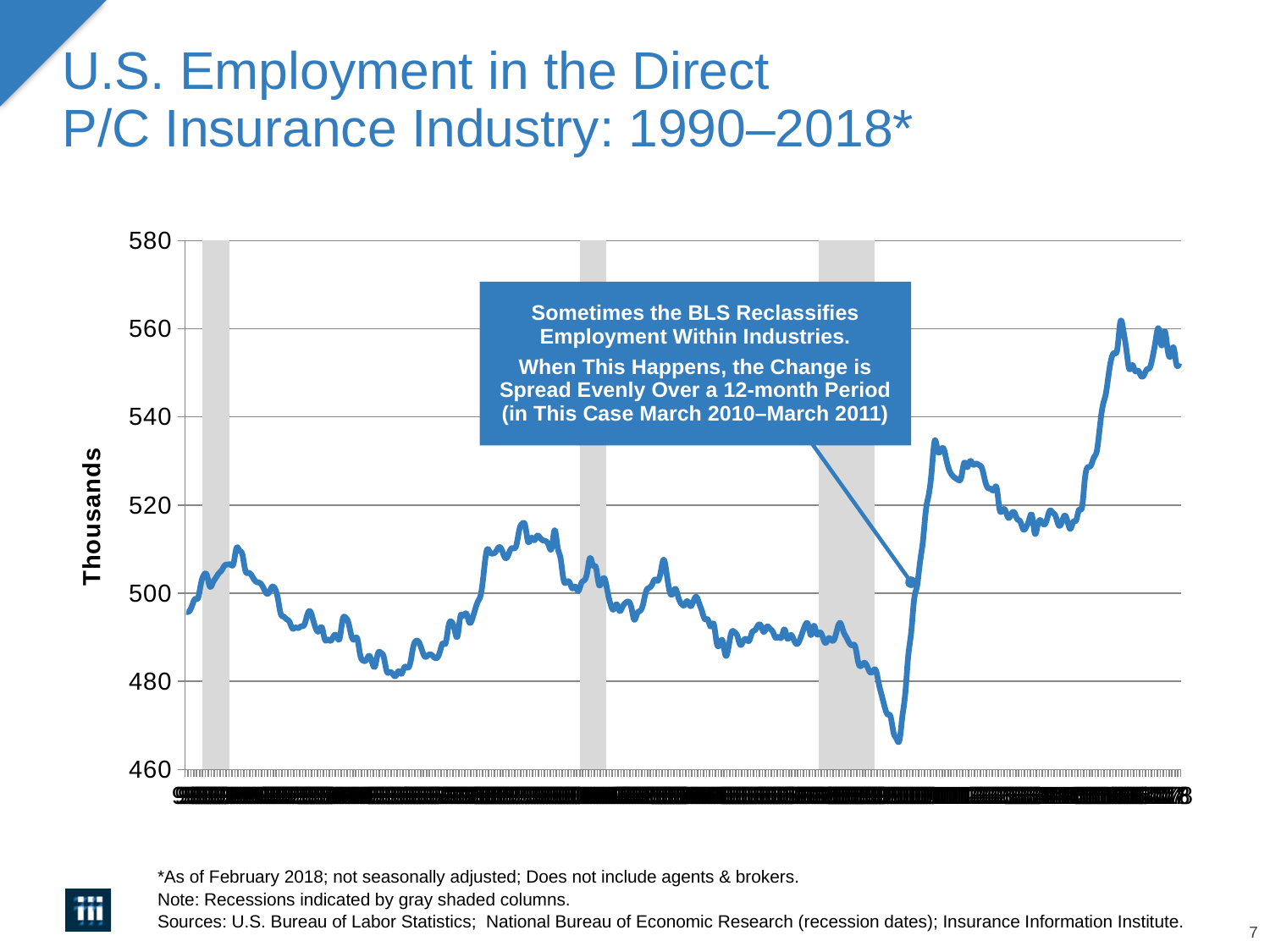
How many gray shaded recession columns are shown on the chart? 3 Is the lowest point of the employment line greater or less than 480? less Is the value at the end of the line (right end) greater or less than 540? greater Over which 12-month period does the callout say the BLS reclassification change was spread? March 2010–March 2011 What kind of chart is shown on the slide? Line chart What is the title of the chart on the slide? U.S. Employment in the Direct P/C Insurance Industry: 1990–2018* Is the highest point of the employment line greater or less than 540? greater What is the label on the vertical axis of the chart? Thousands Does the employment line end higher or lower than where it starts? higher